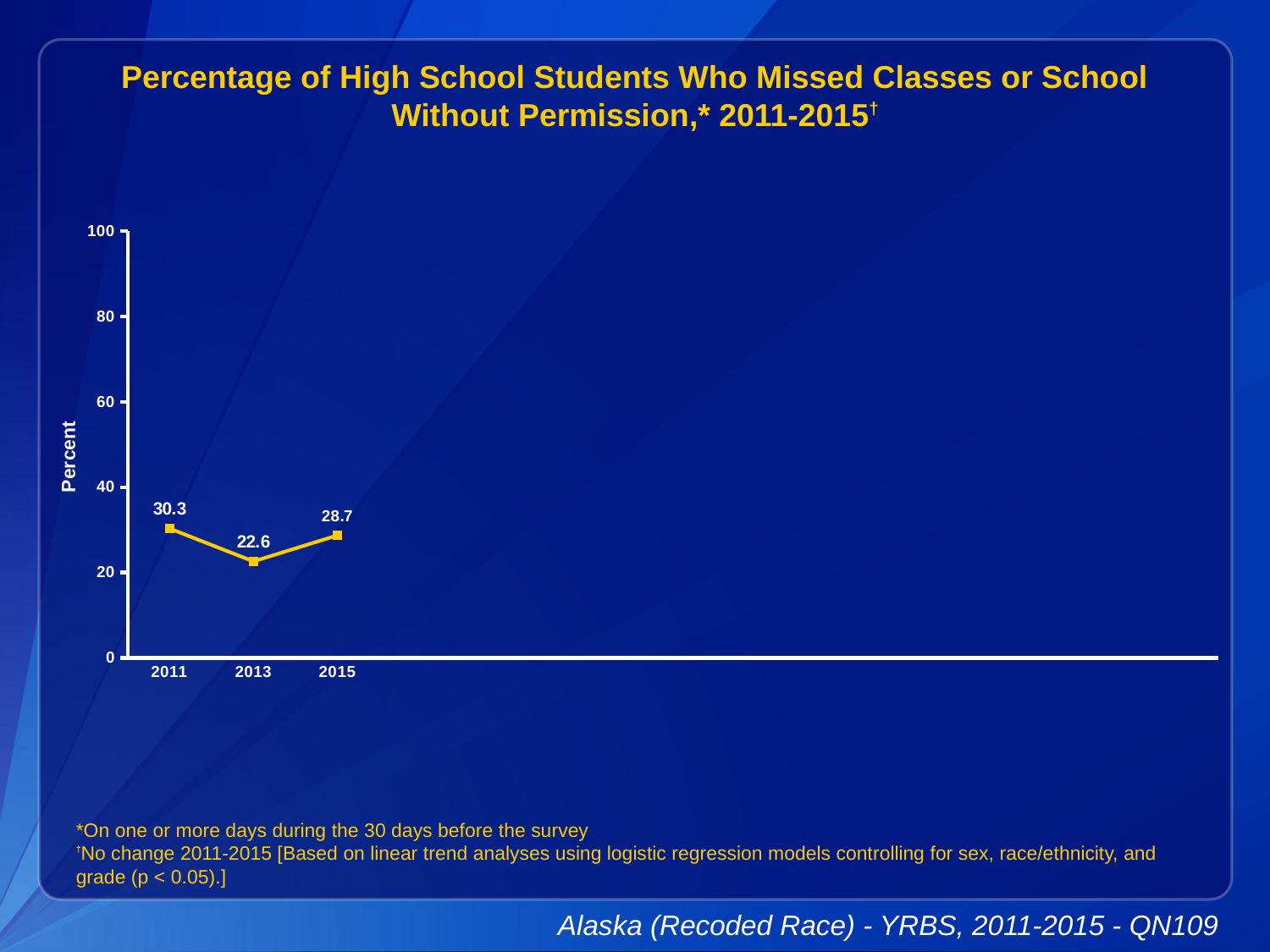
What is the value plotted for 2013? 22.6 Which year has the highest percentage? 2011 What is the difference between the 2011 and 2013 values? 7.7 What is the label on the vertical axis? Percent How many years are plotted on the chart? 3 What kind of chart is shown on the slide? line chart What percentage of high school students missed classes or school without permission in 2011? 30.3 Is the value for 2013 greater or less than 40? less What is the difference between the 2015 and 2013 values? 6.1 What is the value plotted for 2015? 28.7 Which year has the lowest percentage? 2013 Which year has a larger value, 2011 or 2015? 2011